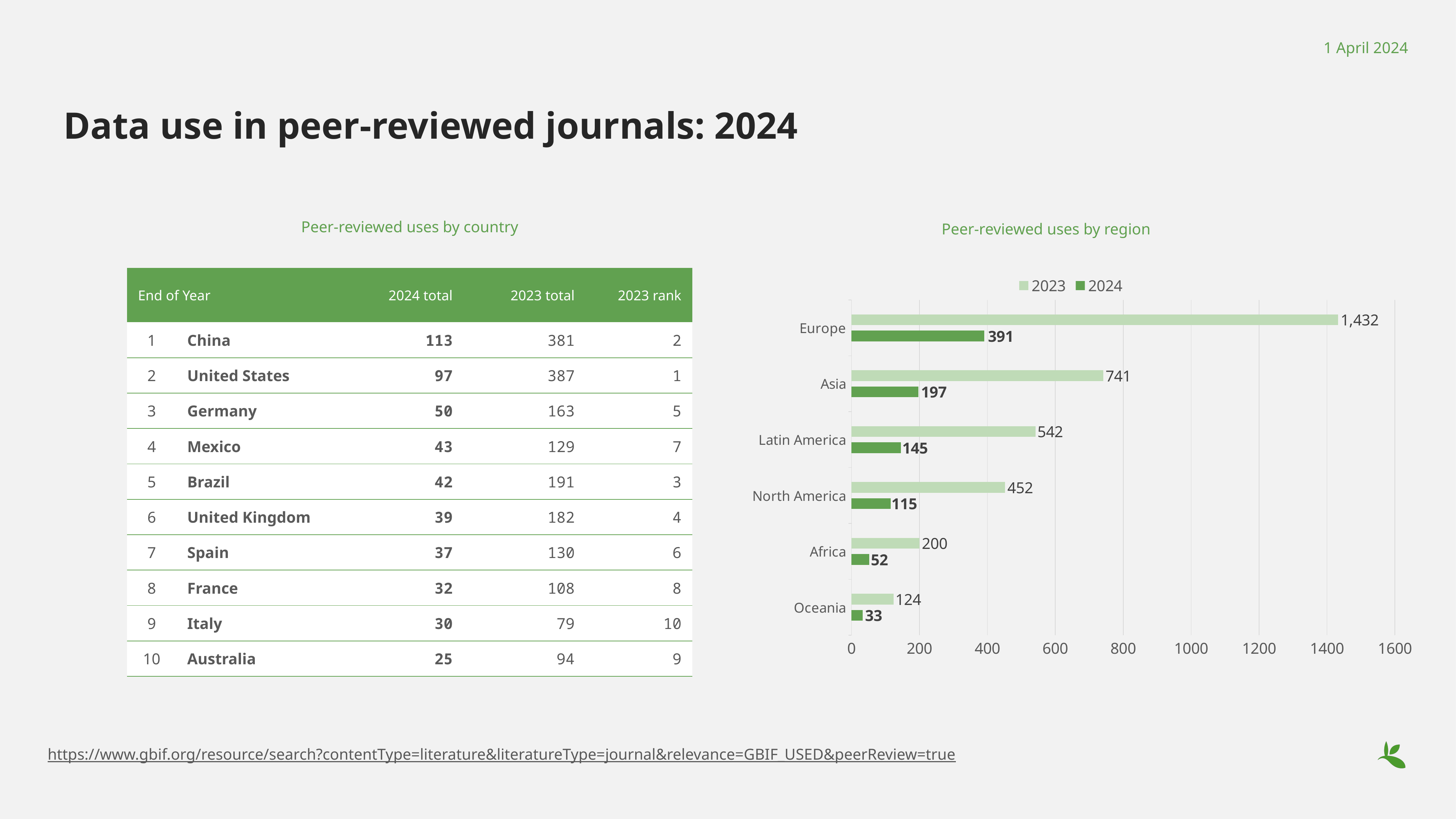
In the 'Peer-reviewed uses by region' chart, what is the difference between the 2023 and 2024 values for Latin America? 397 In the 'Peer-reviewed uses by region' chart, what is the 2024 value for Oceania? 33 In the 'Peer-reviewed uses by region' chart, which region has the highest 2023 value? Europe In the 'Peer-reviewed uses by region' chart, what is the 2023 value for Europe? 1,432 In the 'Peer-reviewed uses by region' chart, is the 2023 value for Asia greater or less than 600? greater How many regions are shown in the 'Peer-reviewed uses by region' chart? 6 What kind of chart is 'Peer-reviewed uses by region'? Bar chart In the 'Peer-reviewed uses by region' chart, what is the difference between the 2023 values for Africa and Oceania? 76 In the 'Peer-reviewed uses by region' chart, which is larger: the 2024 value for Europe or the 2023 value for North America? 2023 value for North America In the 'Peer-reviewed uses by region' chart, which region has the lowest 2024 value? Oceania How many series does the legend of the 'Peer-reviewed uses by region' chart list? 2 In the 'Peer-reviewed uses by region' chart, what is the 2024 value for Asia? 197